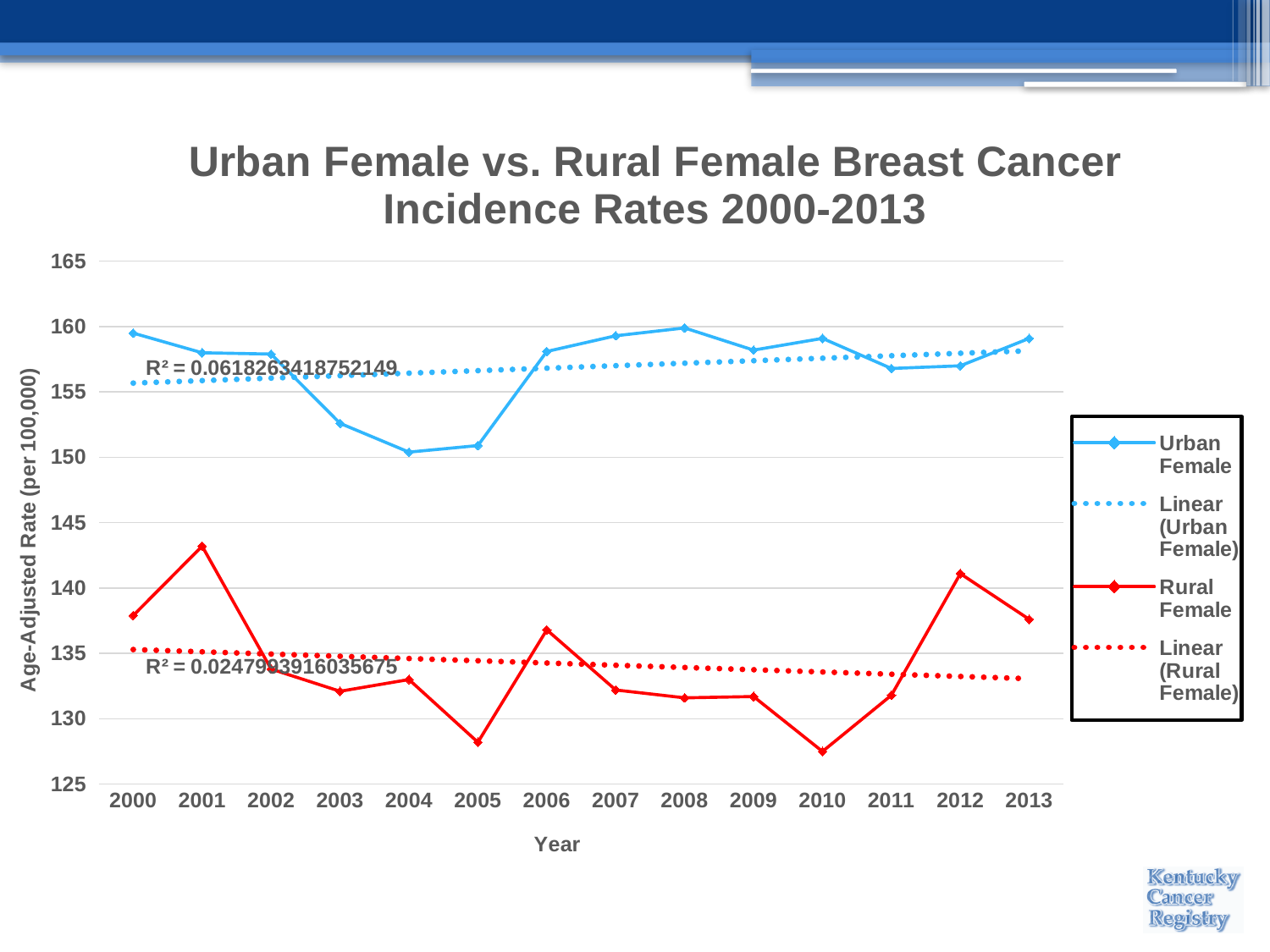
Which is larger for Rural Female, the value in 2001 or the value in 2010? 2001 Is the Urban Female value for 2008 greater or less than 155? greater Which is larger in 2005, the Urban Female rate or the Rural Female rate? Urban Female In which year is the Rural Female incidence rate highest? 2001 Is the Urban Female value for 2004 greater or less than 155? less Does the Linear (Rural Female) trend line rise or fall from 2000 to 2013? fall Is the Rural Female value for 2001 greater or less than 140? greater How many years are plotted along the x axis? 14 How many entries does the legend list? 4 What is the R² value shown for the Urban Female trend line? 0.0618263418752149 What kind of chart is shown on the slide? line chart